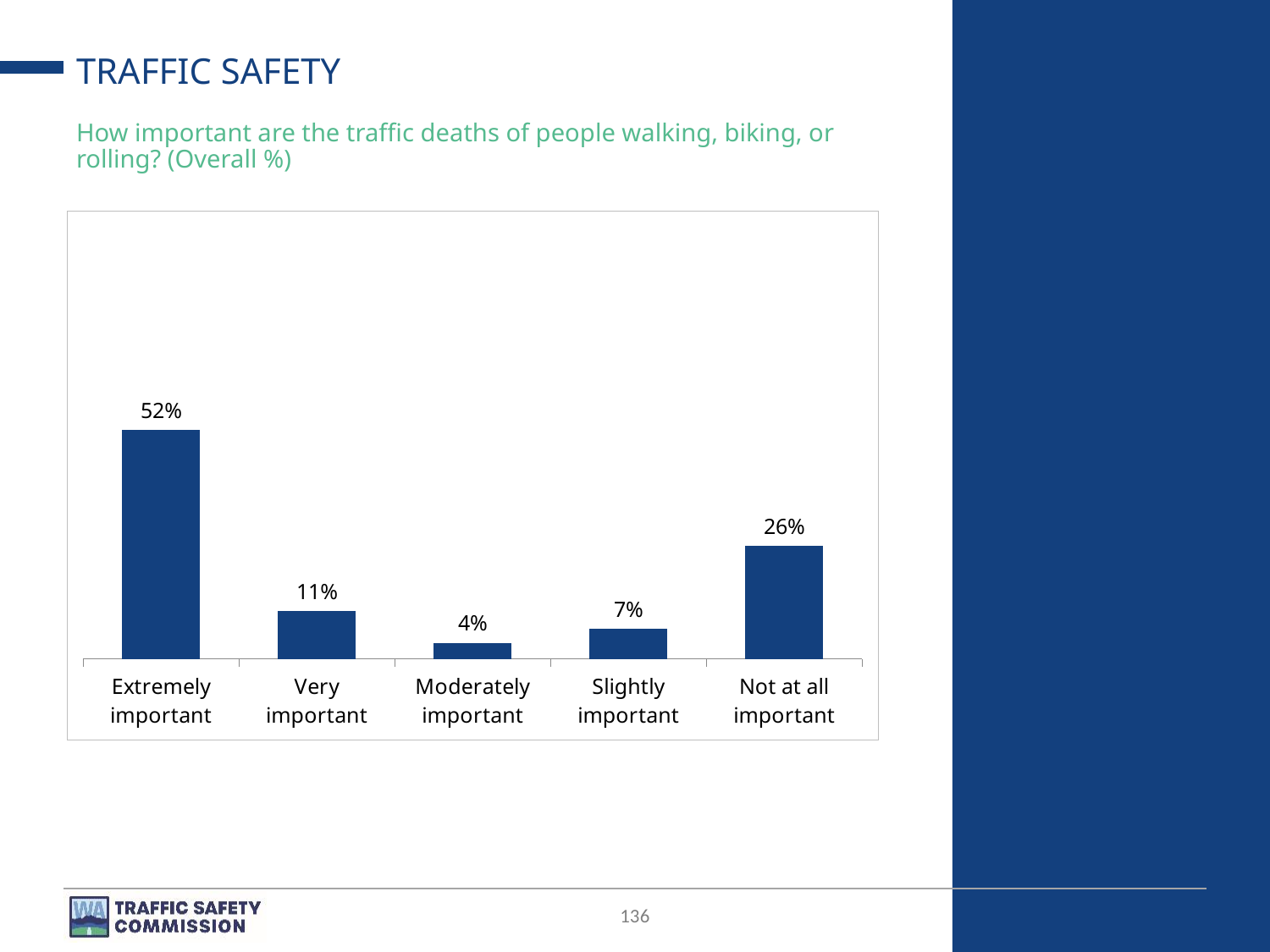
Which category has the highest value? Extremely important What question does the chart's title say respondents were asked? How important are the traffic deaths of people walking, biking, or rolling? (Overall %) What is the value for 'Moderately important'? 4% What is the value for 'Slightly important'? 7% What is the difference between the values for 'Very important' and 'Slightly important'? 4% What kind of chart is shown on the slide? Bar chart How many categories are shown on the x axis? 5 Which is larger, the value for 'Very important' or the value for 'Slightly important'? Very important Which category has the lowest value? Moderately important What is the value for 'Not at all important'? 26% What percentage of respondents said traffic deaths of people walking, biking, or rolling are extremely important? 52% What is the difference between the values for 'Extremely important' and 'Not at all important'? 26%